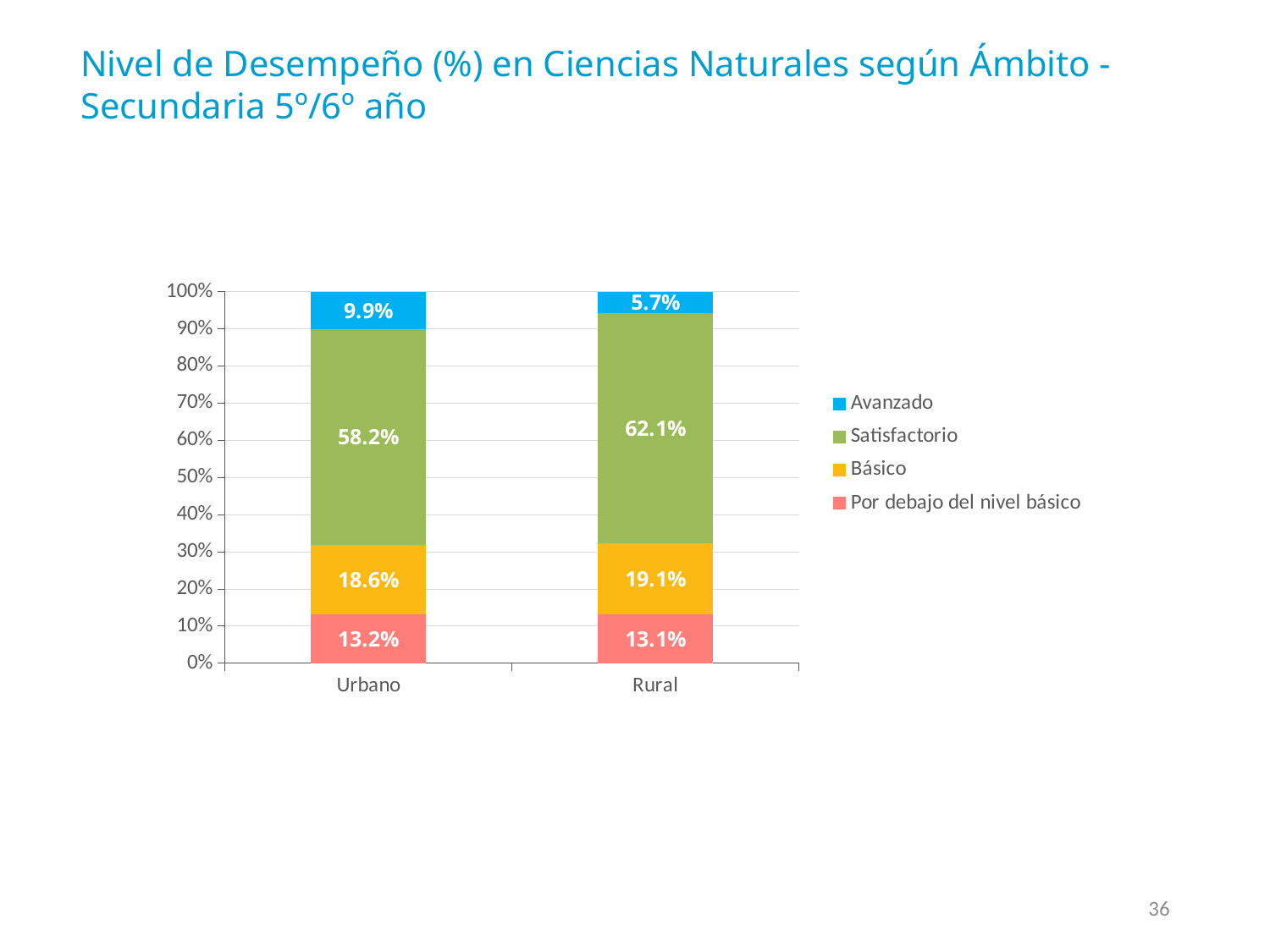
What is the Básico value for Rural? 19.1% What is the Avanzado value for Rural? 5.7% Which series has the smallest value in the Rural bar? Avanzado What is the Satisfactorio value for Urbano? 58.2% What is the Por debajo del nivel básico value for Urbano? 13.2% Which category has the higher Satisfactorio value, Urbano or Rural? Rural Which category has the higher Avanzado value, Urbano or Rural? Urbano What is the difference between the Satisfactorio values for Rural and Urbano? 3.9% Which series has the largest value in the Urbano bar? Satisfactorio What kind of chart is shown on the slide? Stacked bar chart What is the difference between the Avanzado values for Urbano and Rural? 4.2% How many series does the legend list? 4